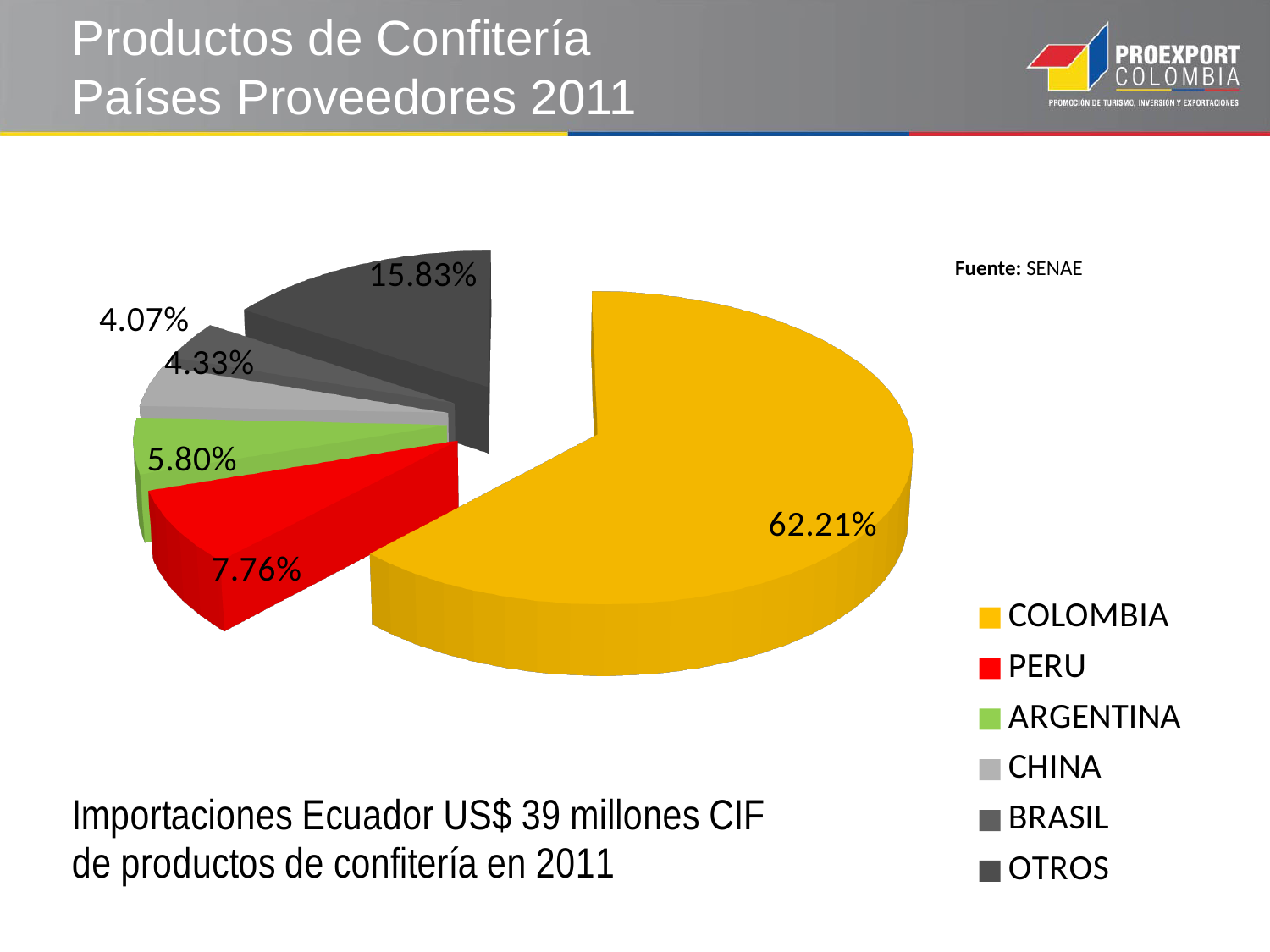
What colour is the COLOMBIA slice in the pie chart? Yellow What source is cited for the chart data? SENAE How many slices does the pie chart have? 6 What share of the pie does COLOMBIA hold? 62.21% What is the difference in percentage points between COLOMBIA and OTROS? 46.38 Which is larger, the share for PERU or the share for ARGENTINA? PERU What percentage is shown for PERU? 7.76% What is the value labelled for ARGENTINA? 5.80% Which category has the smallest slice of the pie? BRASIL Which country has the largest slice of the pie? COLOMBIA What type of chart is shown on the slide? Pie chart What percentage does the OTROS slice show? 15.83%